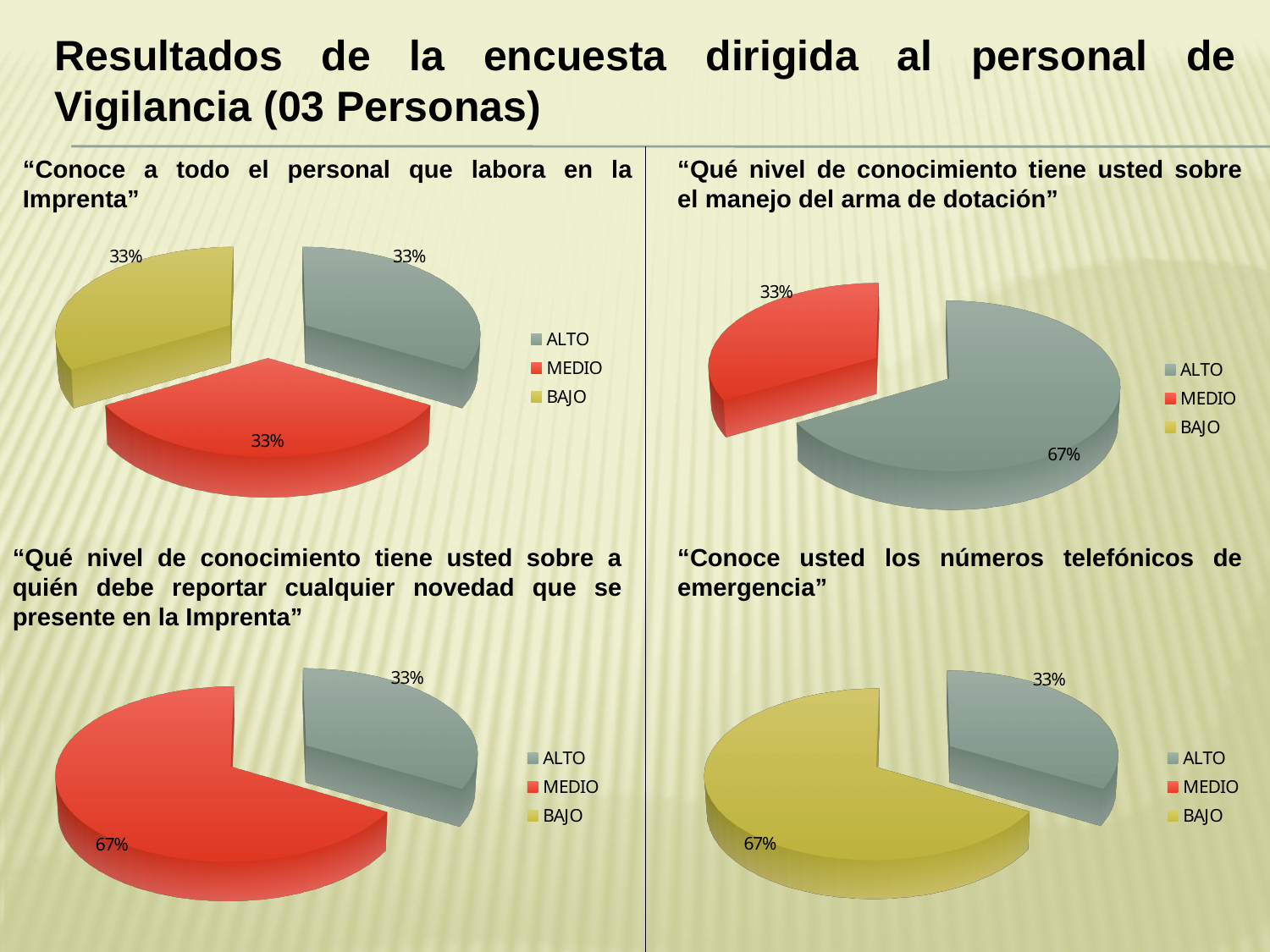
In the top-right chart ("Qué nivel de conocimiento tiene usted sobre el manejo del arma de dotación"), what percentage is shown for ALTO? 67% In the bottom-right chart ("Conoce usted los números telefónicos de emergencia"), which category has the largest slice? BAJO In the bottom-left chart ("Qué nivel de conocimiento tiene usted sobre a quién debe reportar cualquier novedad"), which category has the largest slice? MEDIO In the top-right chart ("Qué nivel de conocimiento tiene usted sobre el manejo del arma de dotación"), which is larger, ALTO or MEDIO? ALTO In the bottom-right chart ("Conoce usted los números telefónicos de emergencia"), what percentage is shown for BAJO? 67% How many entries does the legend of the bottom-right chart ("Conoce usted los números telefónicos de emergencia") list? 3 In the bottom-left chart ("Qué nivel de conocimiento tiene usted sobre a quién debe reportar cualquier novedad"), what percentage is shown for MEDIO? 67% In the top-right chart ("Qué nivel de conocimiento tiene usted sobre el manejo del arma de dotación"), what percentage is shown for MEDIO? 33% In the top-left chart ("Conoce a todo el personal que labora en la Imprenta"), what percentage is shown for BAJO? 33% In the top-right chart ("Qué nivel de conocimiento tiene usted sobre el manejo del arma de dotación"), what is the difference between the ALTO and MEDIO percentages? 34% What kind of chart is used in the top-left chart ("Conoce a todo el personal que labora en la Imprenta")? Pie chart In the bottom-right chart ("Conoce usted los números telefónicos de emergencia"), what percentage is shown for ALTO? 33%